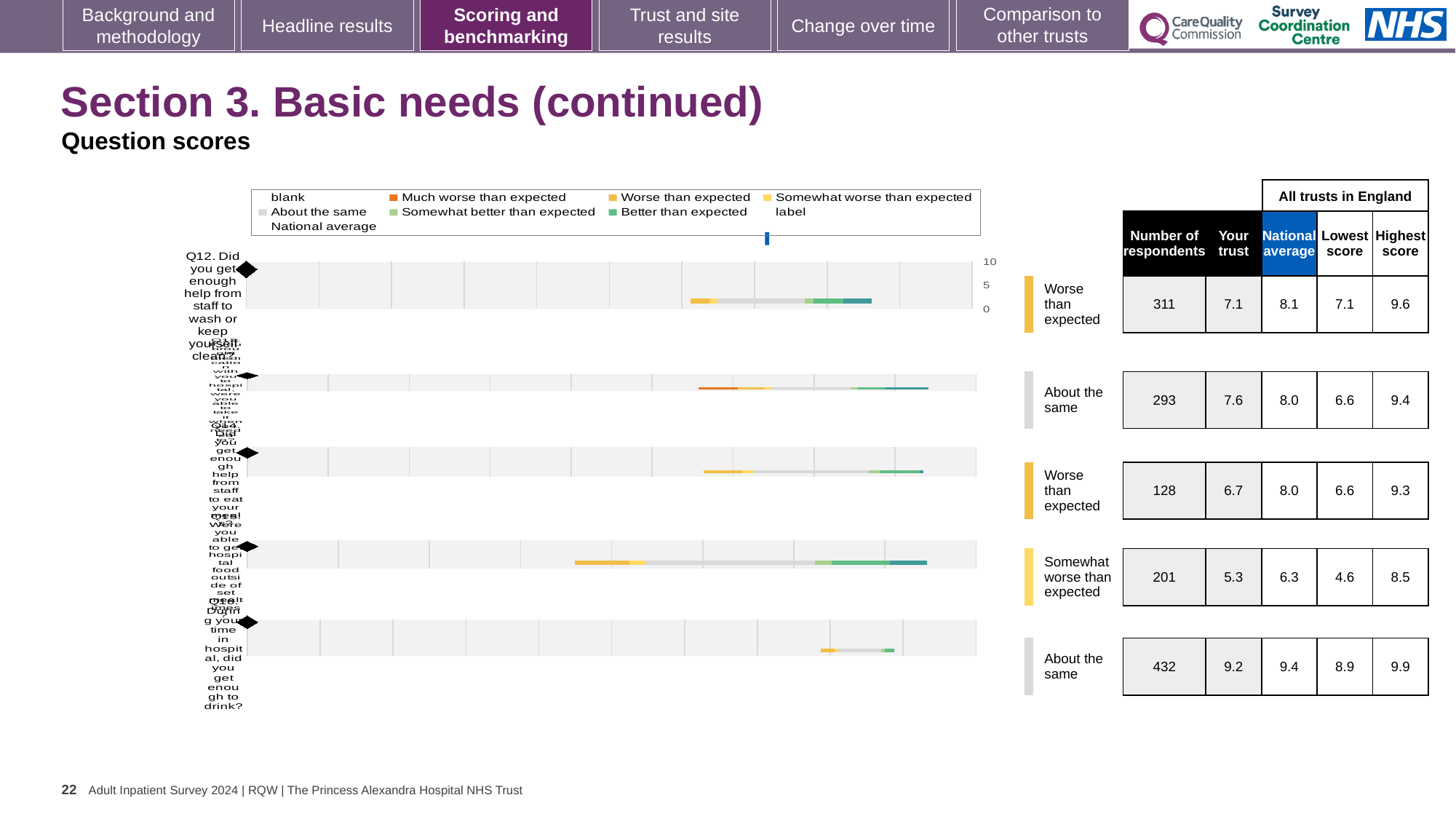
In the table beside the chart, what is the 'Your trust' score for the first row (Q12)? 7.1 What is the label of the first (top) category in the chart? Q12. Did you get enough help from staff to wash or keep yourself clean? What benchmark category is shown for the fourth row (Q15)? Somewhat worse than expected How many respondents are listed for the third row (Q14)? 128 For the second row (Q13), which is larger: the Your trust score or the National average? National average What kind of chart is shown on the slide? bar chart For the first row (Q12), what is the difference between the National average and the Your trust score? 1.0 Which row in the table has the highest 'Your trust' score? the last row (Q16), 9.2 In the table beside the chart, what is the 'National average' for the last row (Q16)? 9.4 How many question rows (bars) are plotted in the chart? 5 In the chart legend, what colour represents 'Much worse than expected'? orange Which row in the table has the lowest 'Your trust' score? the fourth row (Q15), 5.3